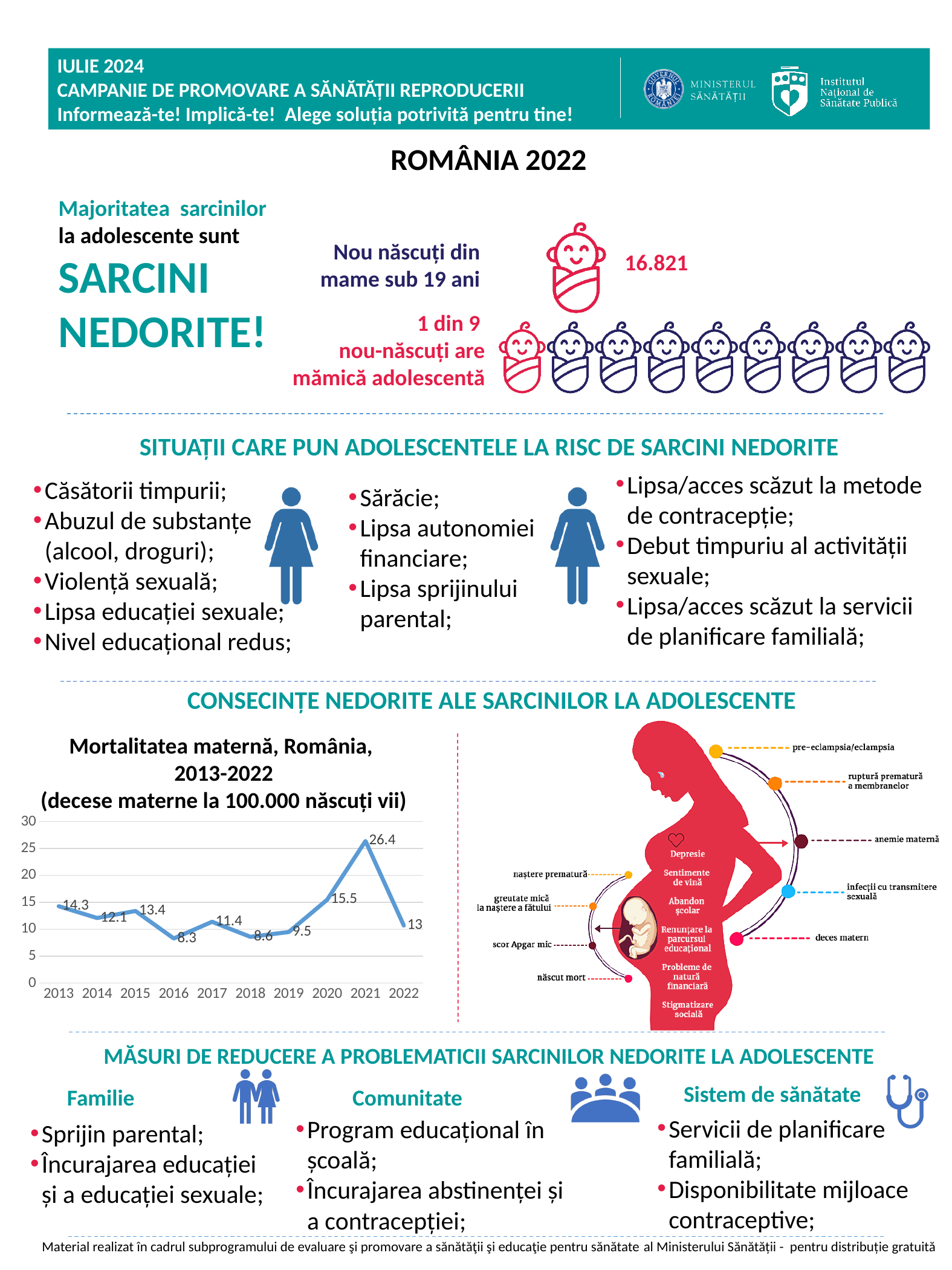
What type of chart is used to show maternal mortality in Romania, 2013-2022? line chart Which year has the highest maternal mortality value in the chart? 2021 What was the maternal mortality value in Romania in 2021? 26.4 Which year has a higher maternal mortality value, 2014 or 2015? 2015 Which year has the lowest maternal mortality value in the chart? 2016 What was the maternal mortality value in Romania in 2022? 13 How many years are plotted in the maternal mortality chart? 10 What unit does the maternal mortality chart title say the values are in? decese materne la 100.000 născuți vii Did maternal mortality rise or fall from 2021 to 2022? fall Is the maternal mortality value for 2021 greater or less than 25? greater What was the maternal mortality value in Romania in 2013? 14.3 What is the difference between the maternal mortality values for 2021 and 2020? 10.9